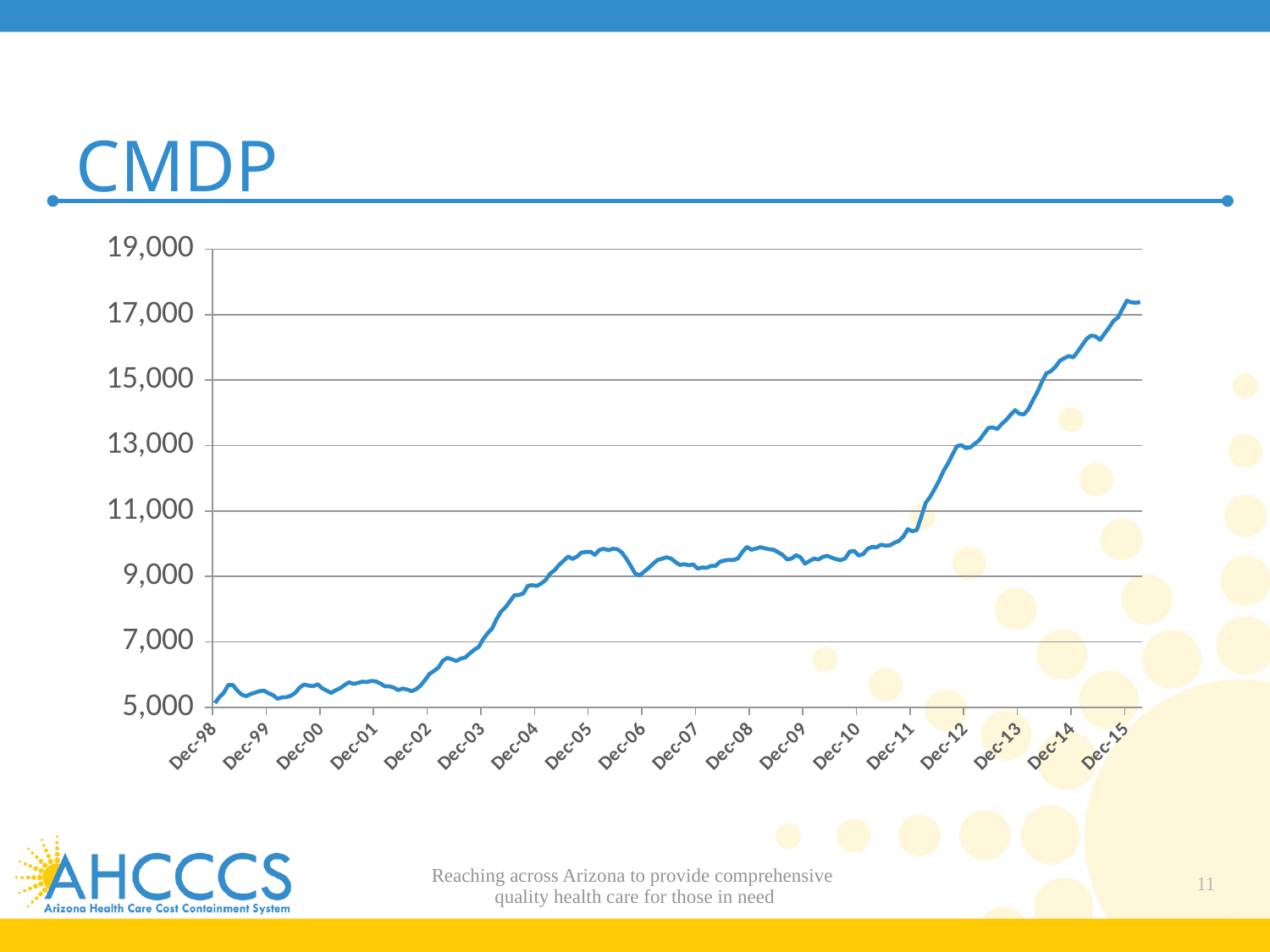
What is the title of the chart? CMDP What is the highest value shown on the y axis? 19,000 How many year labels are shown on the x axis? 18 Is the value at Dec-98 greater or less than 7,000? less Which is larger, the value at Dec-14 or the value at Dec-08? Dec-14 What kind of chart is shown on the slide? line chart Is the value at Dec-13 greater or less than 13,000? greater Overall, do the values rise or fall from Dec-98 to Dec-15? rise At which x-axis label is the plotted value highest? Dec-15 Is the value at Dec-15 greater or less than 15,000? greater At which x-axis label is the plotted value lowest? Dec-98